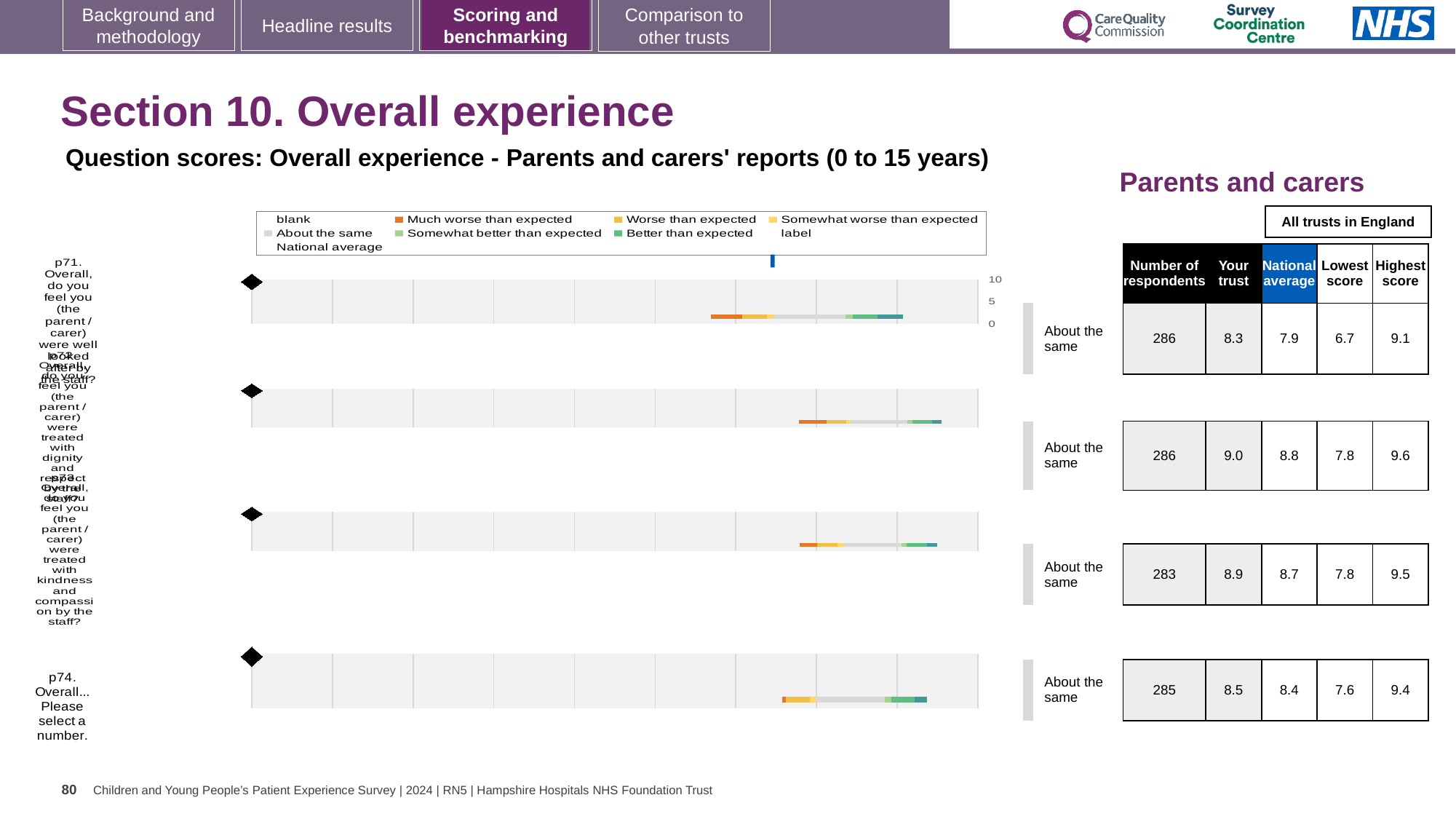
What benchmark category is shown for p74? About the same What is the 'Your trust' score for p74 (the last row)? 8.5 What is the national average for the second row (p72)? 8.8 What is the number of respondents for p71 (the first row)? 286 What is the highest score across all trusts in England for the second row (p72)? 9.6 Which row has the highest 'Your trust' score? p72 (second row), 9.0 For p71, what is the difference between the 'Your trust' score and the national average? 0.4 Which row has the lowest 'Your trust' score? p71 (first row), 8.3 How many questions (rows) are plotted in the chart? 4 What kind of chart is used to show the question scores on this slide? bar chart What is the lowest score across all trusts in England for p74? 7.6 For the third row (p73), which is larger: the 'Your trust' score or the national average? Your trust (8.9)